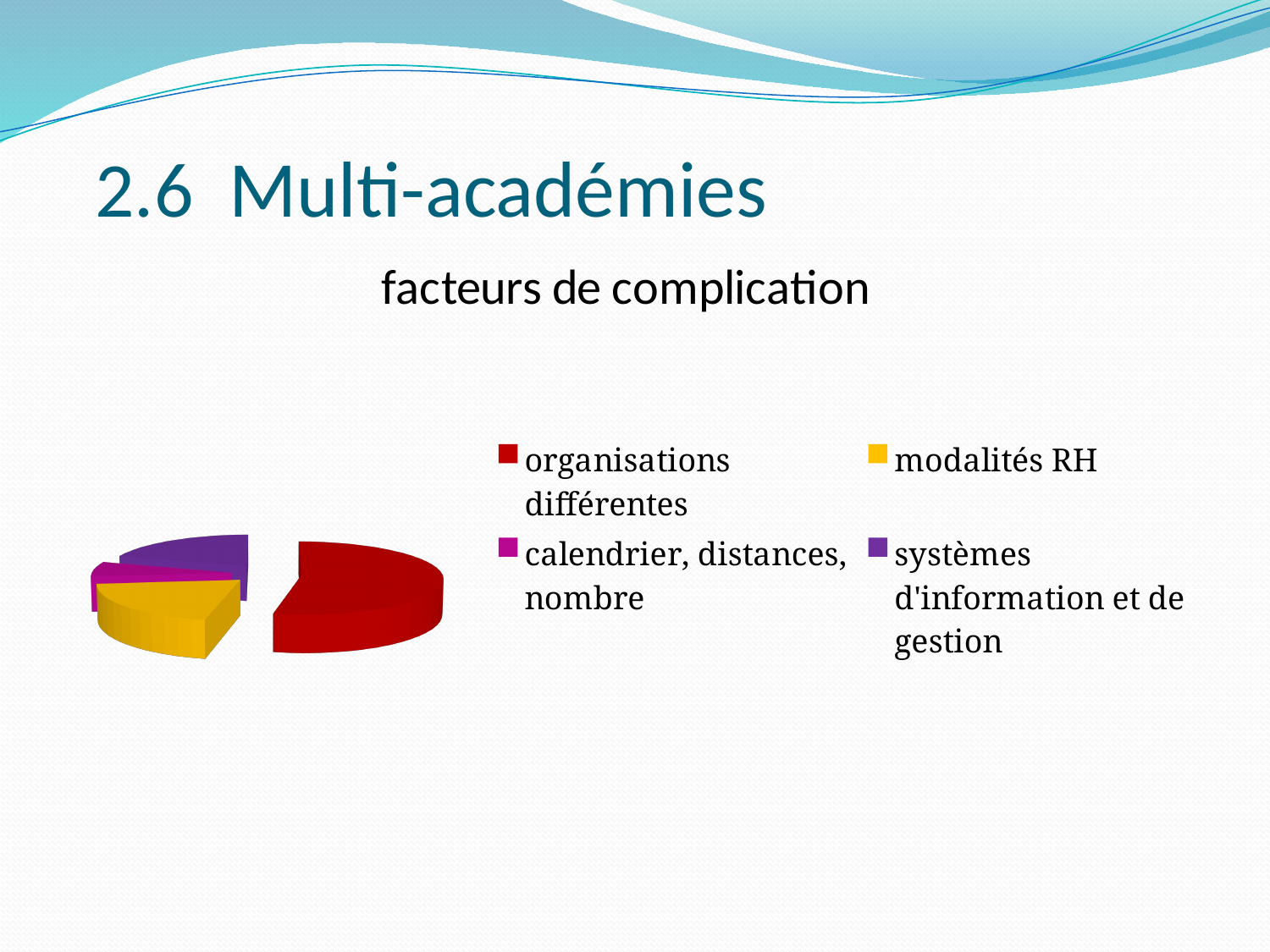
What kind of chart is shown on the slide? pie chart What is the title shown above the pie chart? facteurs de complication Which category has the largest slice of the pie chart? organisations différentes Which slice is larger: organisations différentes or modalités RH? organisations différentes Which slice is larger: systèmes d'information et de gestion or calendrier, distances, nombre? systèmes d'information et de gestion What colour is the slice for organisations différentes? red Which category has the smallest slice of the pie chart? calendrier, distances, nombre Which slice is larger: modalités RH or calendrier, distances, nombre? modalités RH How many slices does the pie chart have? 4